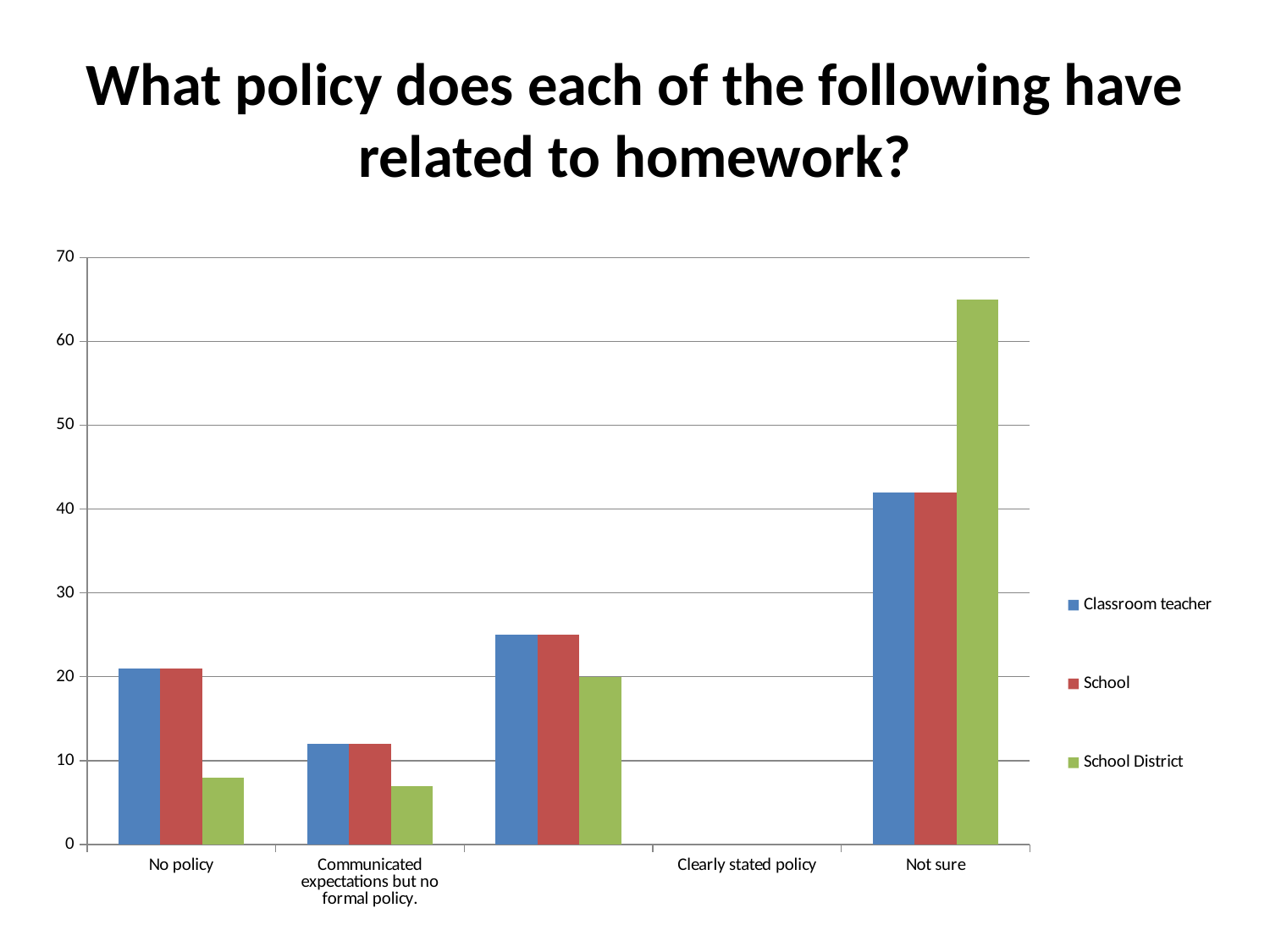
Is the School District value for Not sure greater or less than 60? greater Which category has the highest School District value? Not sure What kind of chart is shown on the slide? bar chart For Not sure, which is larger: the Classroom teacher value or the School District value? School District Is the Classroom teacher value for Not sure greater or less than 40? greater What colour are the School bars? red Which series does the legend list last? School District For No policy, which is larger: the Classroom teacher value or the School District value? Classroom teacher How many series does the legend list? 3 Is the School District value for No policy greater or less than 10? less